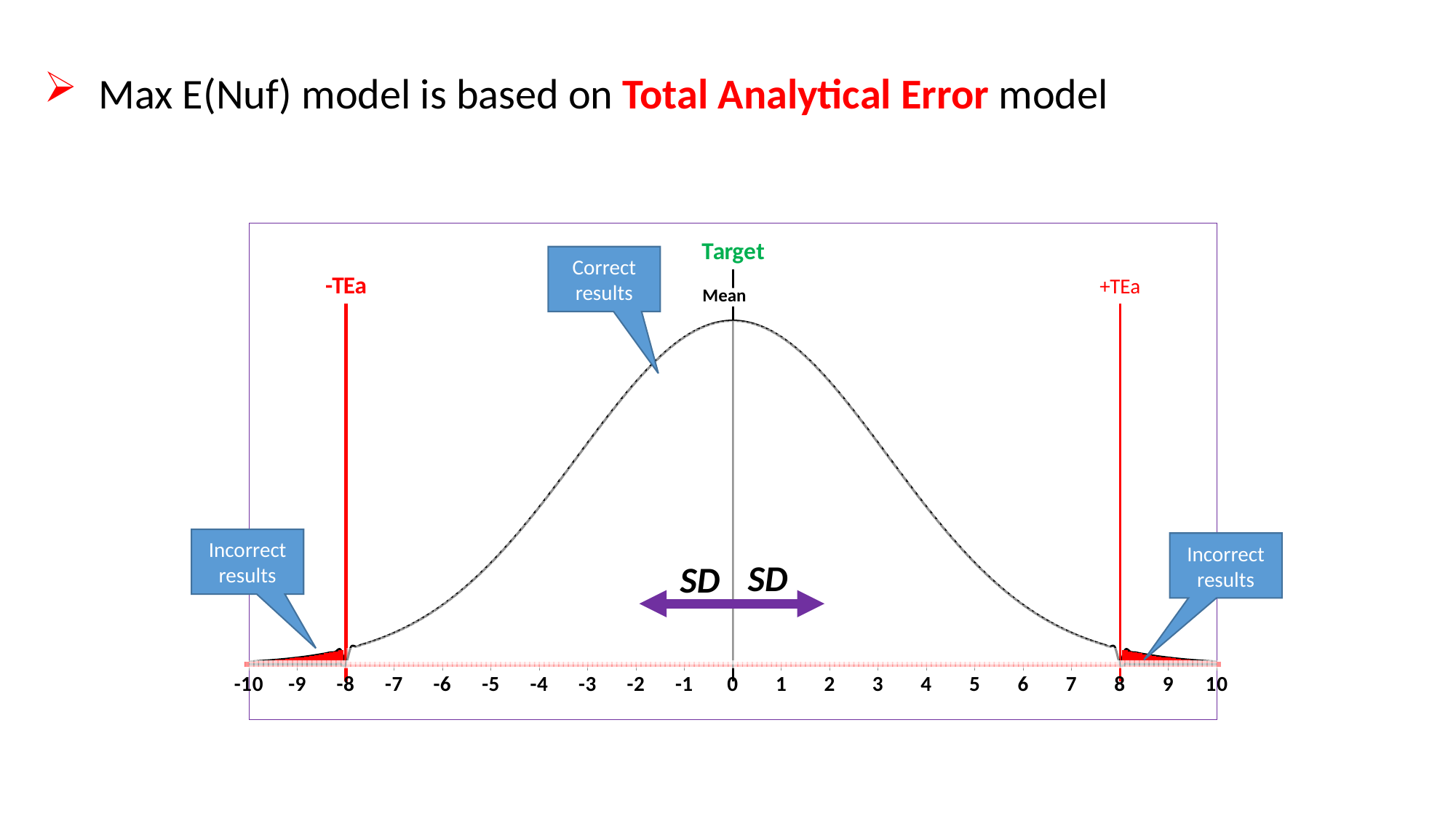
Does the curve rise or fall as x goes from -10 to 0? rise What kind of chart is shown on the slide? line chart What is the highest value labelled on the x axis? 10 At which x-axis value is the line labelled Mean located? 0 How many tick labels are shown on the x axis? 21 Does the curve rise or fall as x goes from 0 to 10? fall At which x-axis value is the vertical red line labelled +TEa drawn? 8 At which x-axis value is the vertical red line labelled -TEa drawn? -8 What label is given to the shaded red areas in the tails of the curve beyond -8 and 8? Incorrect results At which x-axis value does the curve reach its highest point? 0 What is the lowest value labelled on the x axis? -10 What label is given to the central part of the curve between -TEa and +TEa? Correct results